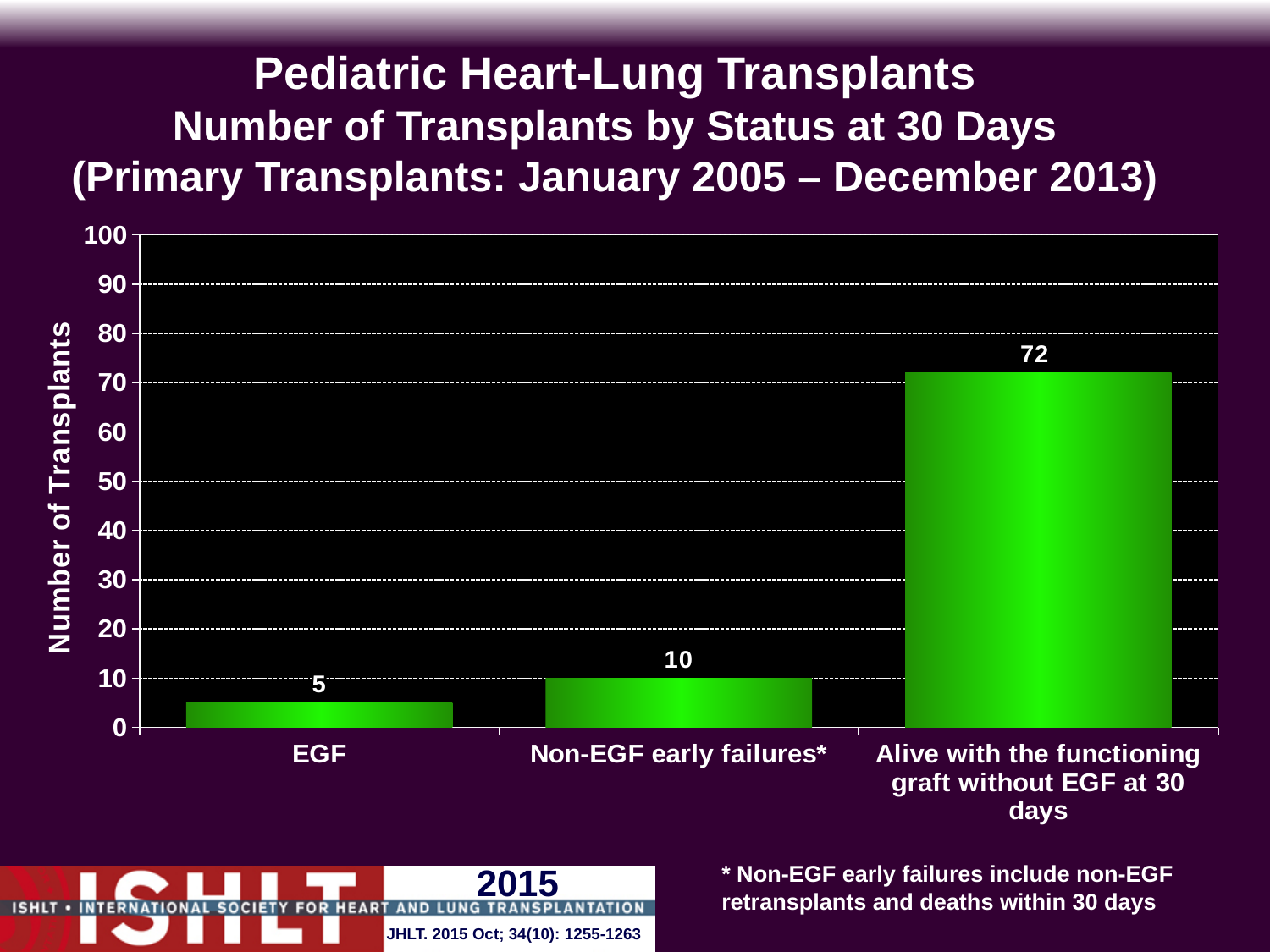
What is the difference in number of transplants between Non-EGF early failures* and EGF? 5 Is the value for Alive with the functioning graft without EGF at 30 days greater or less than 70? greater What is the number of transplants for EGF? 5 What is the number of transplants for Alive with the functioning graft without EGF at 30 days? 72 What is the number of transplants for Non-EGF early failures*? 10 How many categories are shown on the x axis? 3 Which category has the highest number of transplants? Alive with the functioning graft without EGF at 30 days What kind of chart is shown on the slide? Bar chart What is the difference in number of transplants between Alive with the functioning graft without EGF at 30 days and Non-EGF early failures*? 62 Which category has the lowest number of transplants? EGF Which has more transplants, EGF or Non-EGF early failures*? Non-EGF early failures* What is the label of the y axis? Number of Transplants